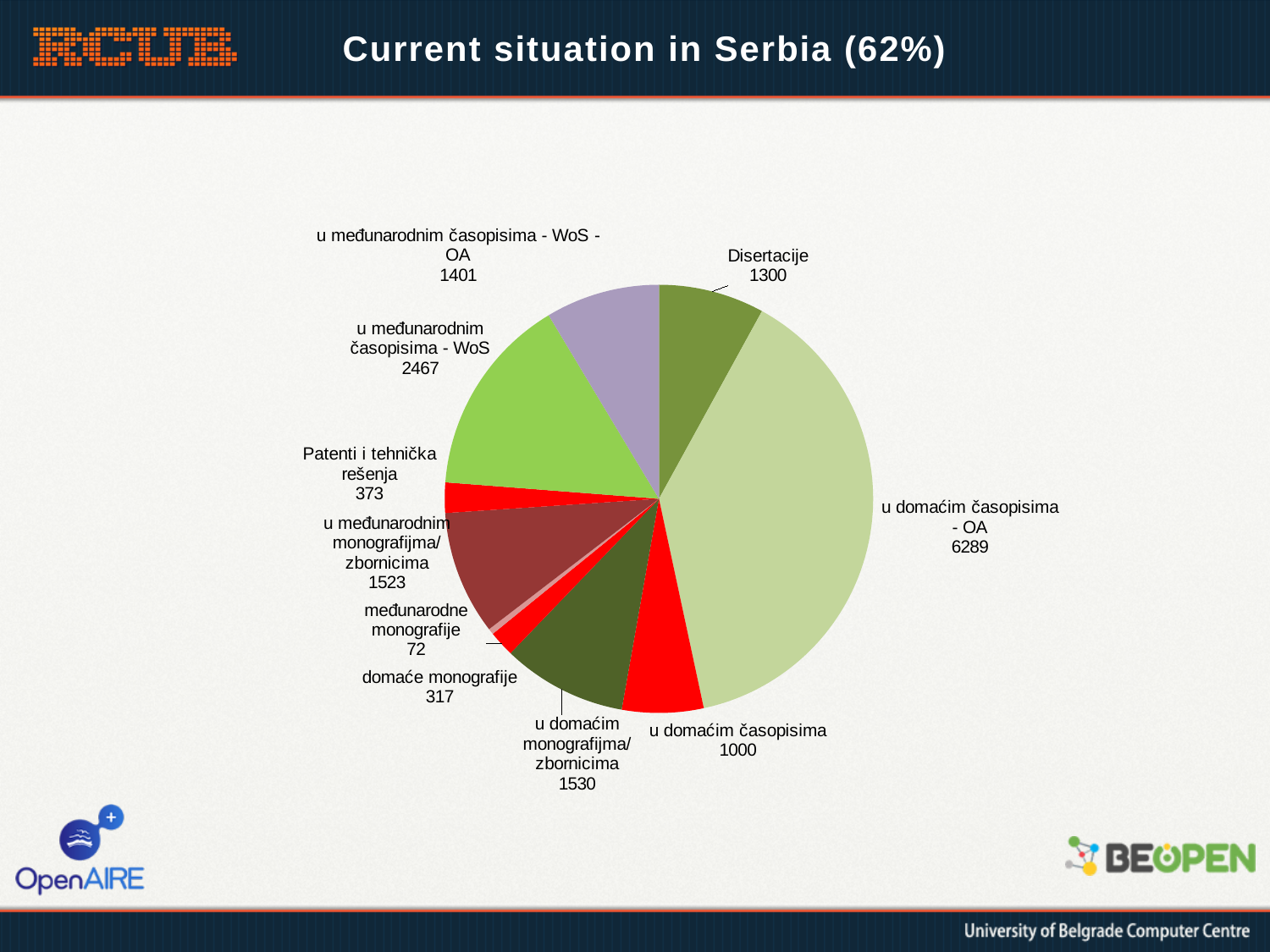
What is the value for "Disertacije"? 1300 What is the title of the slide containing the chart? Current situation in Serbia (62%) What is the value for "u međunarodnim časopisima - WoS"? 2467 What is the value for "u domaćim časopisima - OA"? 6289 What is the value for "Patenti i tehnička rešenja"? 373 Which category has the largest slice of the pie? u domaćim časopisima - OA What is the difference between "domaće monografije" and "međunarodne monografije"? 245 Which is larger, "Disertacije" or "u domaćim časopisima"? Disertacije How many slices does the pie chart have? 10 What is the difference between "u međunarodnim časopisima - WoS" and "u međunarodnim časopisima - WoS - OA"? 1066 Which category has the smallest slice of the pie? međunarodne monografije What kind of chart is shown on the slide? pie chart